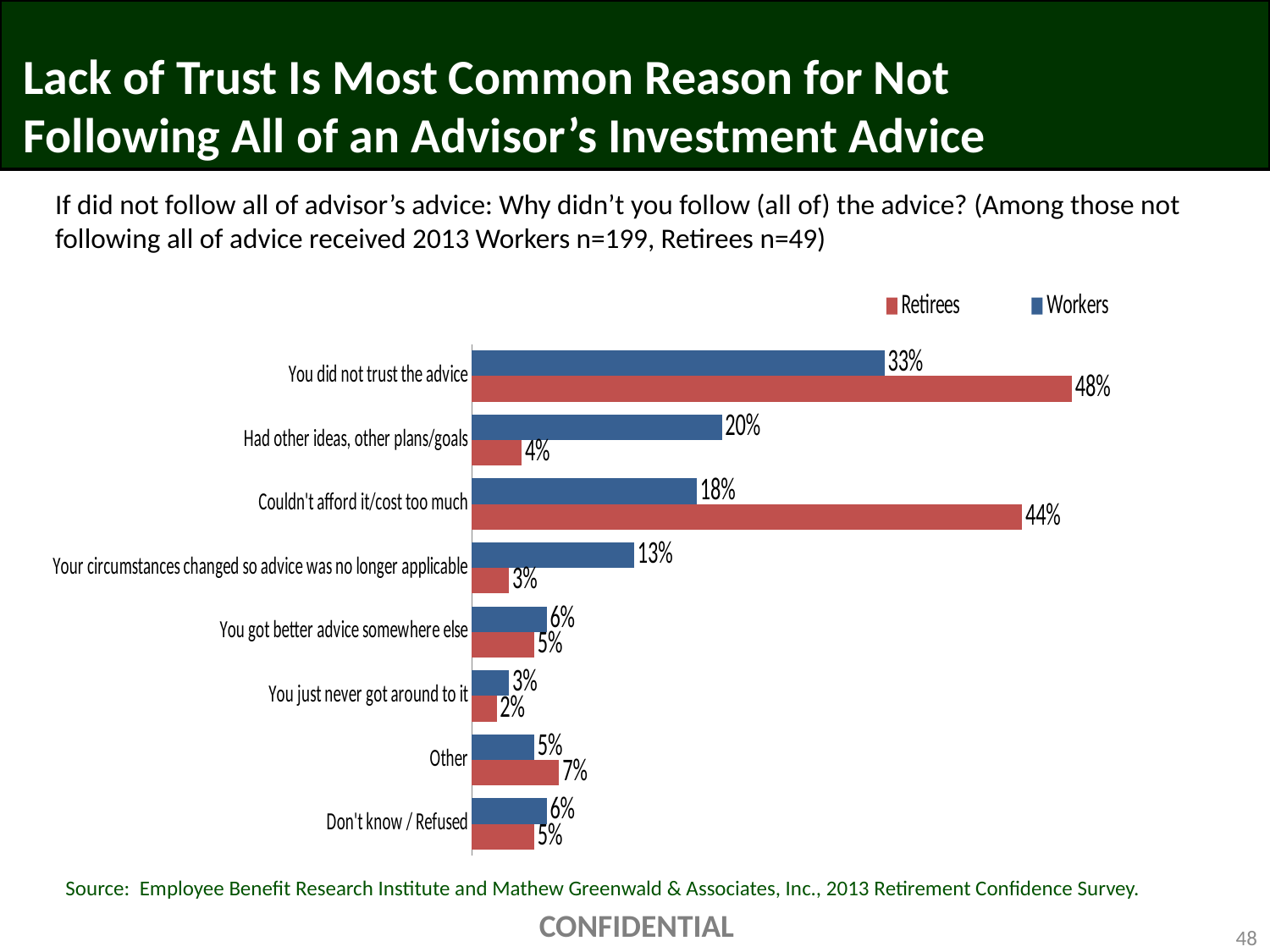
Which category has the highest value for Retirees? You did not trust the advice Which category has the lowest value for Workers? You just never got around to it For 'Couldn't afford it/cost too much', which group has the larger value, Workers or Retirees? Retirees What is the Retirees value for 'Had other ideas, other plans/goals'? 4% How many series does the legend list? 2 What kind of chart is shown on the slide? Bar chart What percentage of Retirees said they couldn't afford it/cost too much? 44% For 'Your circumstances changed so advice was no longer applicable', which group has the larger value, Workers or Retirees? Workers What percentage of Workers said they did not trust the advice? 33% What is the difference between the Retirees and Workers values for 'You did not trust the advice'? 15 percentage points How many categories are shown on the chart? 8 Which colour represents Retirees in the chart? Red